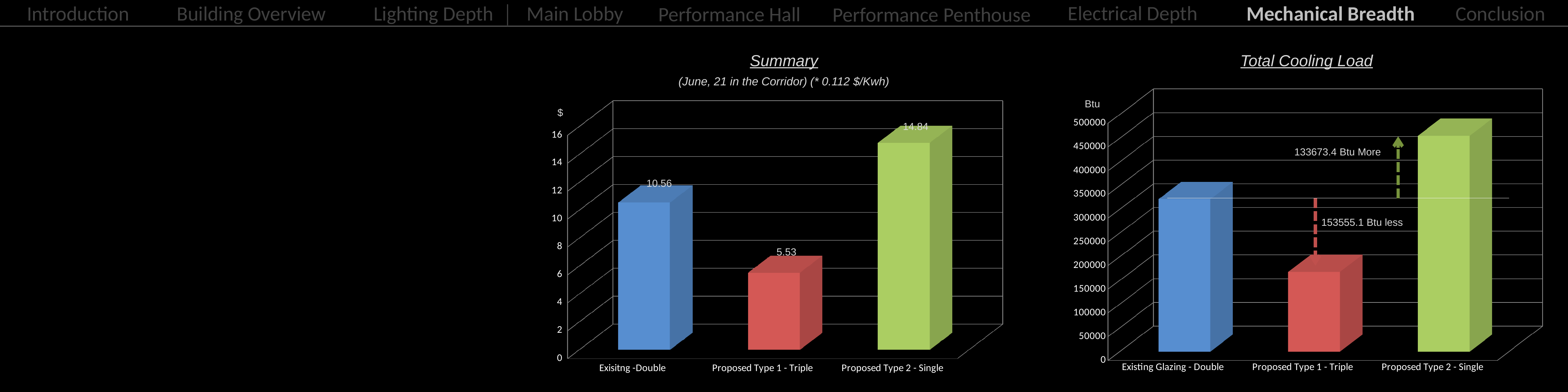
In the Summary chart, which category has the lowest value? Proposed Type 1 - Triple In the Summary chart, what is the value for Exisitng -Double? 10.56 In the Summary chart, what is the value for Proposed Type 2 - Single? 14.84 In the Summary chart, what is the difference between the values for Proposed Type 2 - Single and Exisitng -Double? 4.28 In the Total Cooling Load chart, is the value for Proposed Type 2 - Single greater or less than 400000? greater What kind of chart is the Total Cooling Load chart? Bar chart In the Total Cooling Load chart, is the value for Proposed Type 1 - Triple greater or less than 250000? less In the Summary chart, how many categories are shown? 3 In the Summary chart, which category has the highest value? Proposed Type 2 - Single In the Summary chart, what is the value for Proposed Type 1 - Triple? 5.53 What unit is shown on the vertical axis of the Total Cooling Load chart? Btu In the Total Cooling Load chart, which is larger, the value for Existing Glazing - Double or Proposed Type 1 - Triple? Existing Glazing - Double